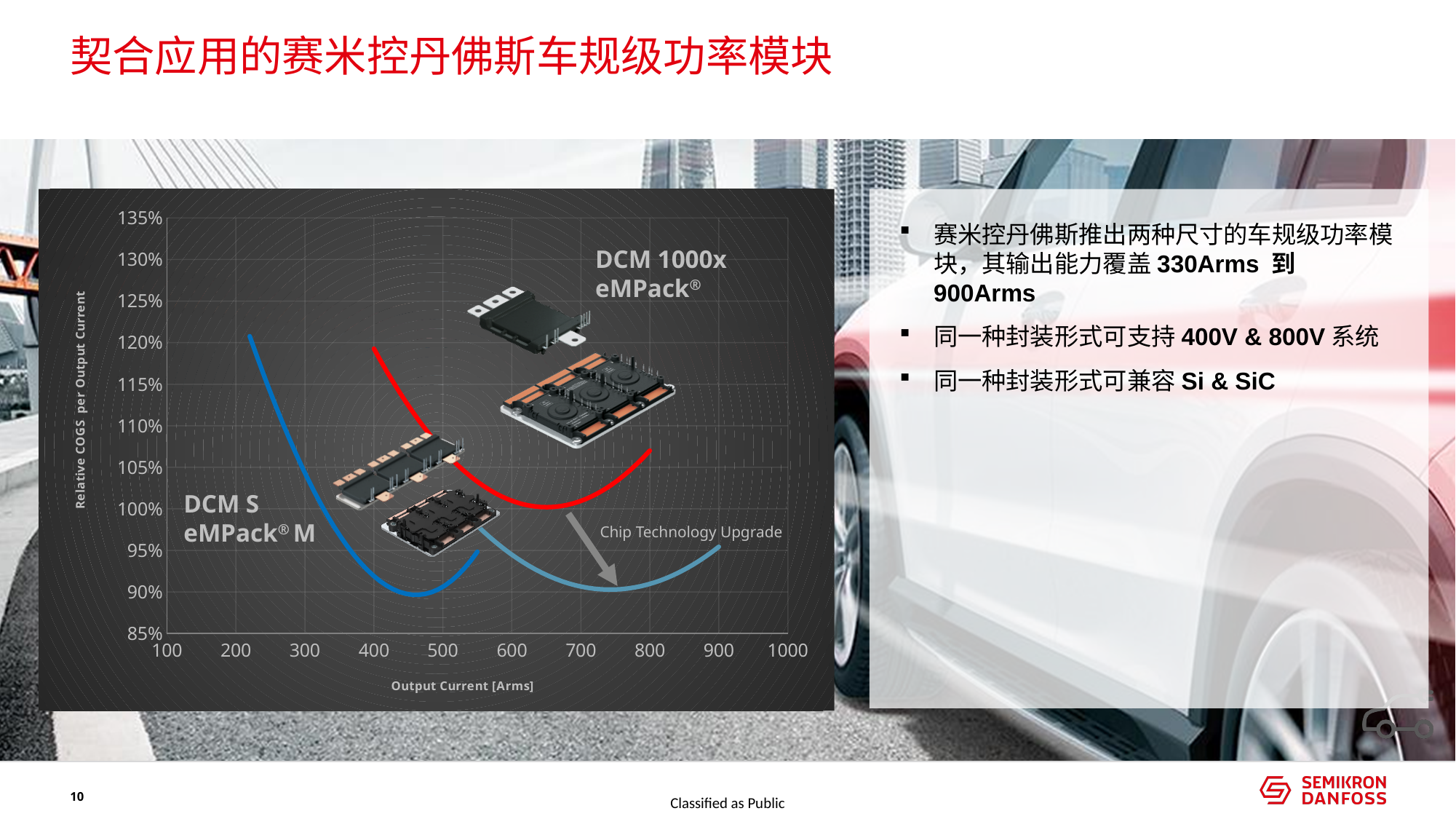
Does the red DCM 1000x eMPack curve rise or fall between 700 Arms and 800 Arms? rise Is the lowest point of the blue DCM S eMPack M curve greater or less than 95%? less Is the lowest point of the light blue curve after the chip technology upgrade greater or less than 95%? less What text is written next to the grey arrow in the chart? Chip Technology Upgrade Is the value of the blue DCM S eMPack M curve at 300 Arms greater or less than 100%? greater Which curve reaches a lower minimum relative COGS, the blue DCM S eMPack M curve or the red DCM 1000x eMPack curve? Blue DCM S eMPack M curve What is the label of the x axis of the chart? Output Current [Arms] What kind of chart is shown on the slide? Line chart How many curves are plotted in the chart? 3 Does the blue DCM S eMPack M curve rise or fall between 200 Arms and 450 Arms? fall